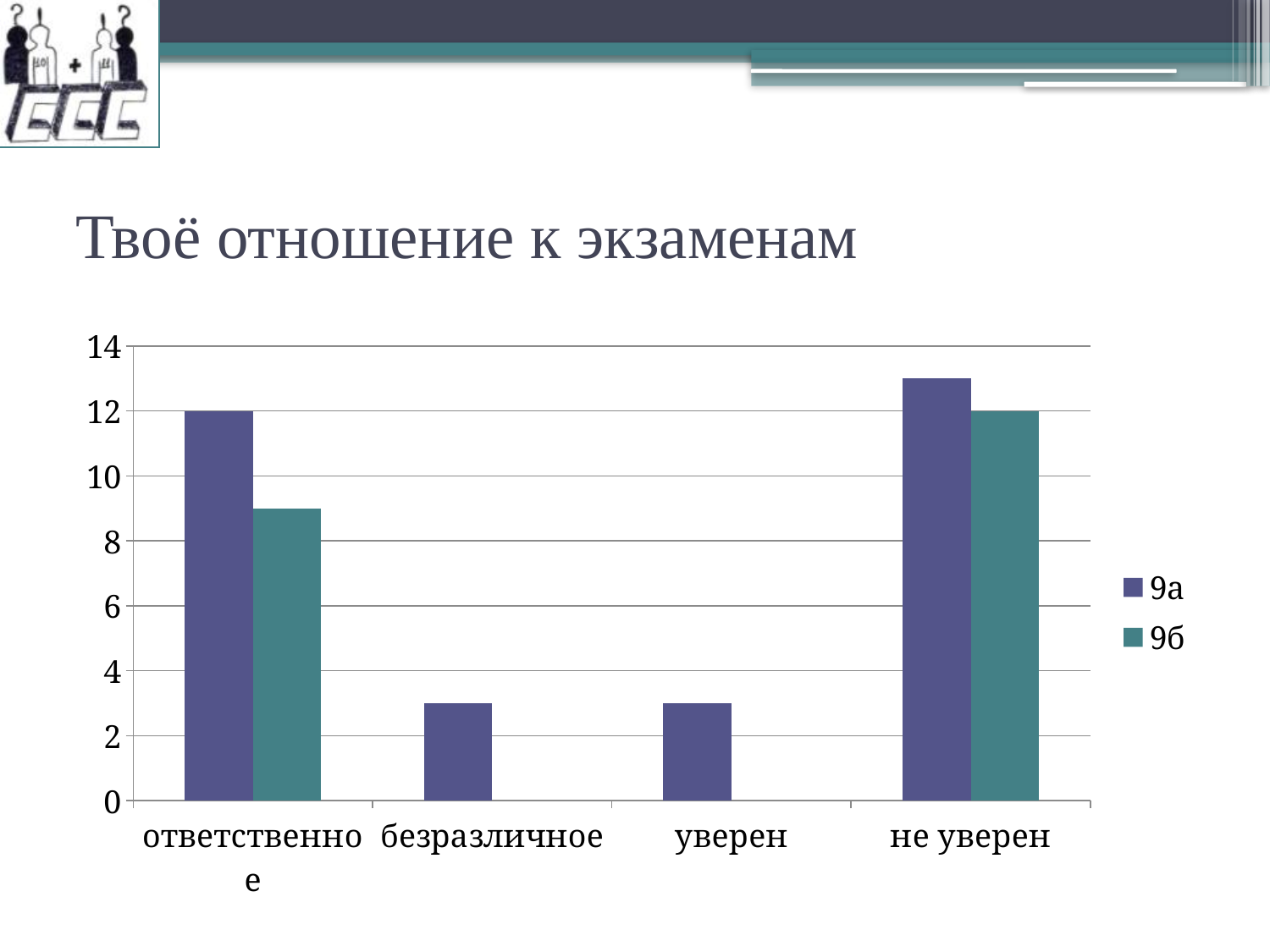
Is the value for 9а in the category не уверен greater or less than 12? greater Which category has the highest value for series 9а? не уверен What kind of chart is shown on the slide? bar chart What is the value for 9б in the category не уверен? 12 What is the title of the chart? Твоё отношение к экзаменам Is the value for 9а in the category уверен greater or less than 4? less In the category ответственное, which series has the larger value, 9а or 9б? 9а Which category has the highest value for series 9б? не уверен How many series does the legend list? 2 Is the value for 9б in the category ответственное greater or less than 10? less How many categories are shown on the x axis? 4 What is the value for 9а in the category ответственное? 12